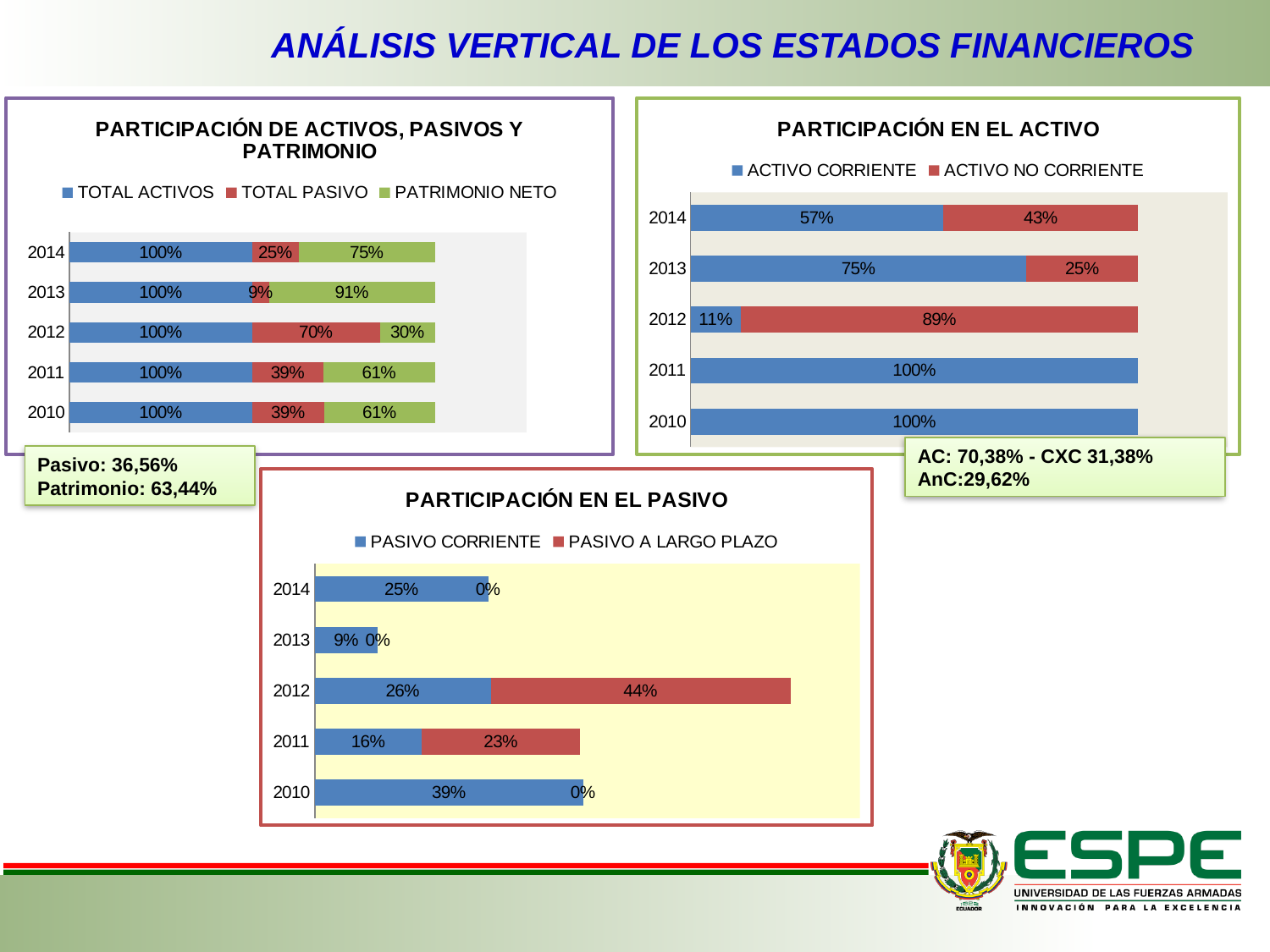
In the chart 'PARTICIPACIÓN EN EL PASIVO', how many series does the legend list? 2 In the chart 'PARTICIPACIÓN EN EL ACTIVO', what is the value of ACTIVO NO CORRIENTE for 2012? 89% In the chart 'PARTICIPACIÓN DE ACTIVOS, PASIVOS Y PATRIMONIO', is TOTAL PASIVO or PATRIMONIO NETO larger in 2014? PATRIMONIO NETO In the chart 'PARTICIPACIÓN EN EL PASIVO', what is the value of PASIVO A LARGO PLAZO for 2012? 44% What kind of chart is 'PARTICIPACIÓN EN EL ACTIVO'? Stacked bar chart In the chart 'PARTICIPACIÓN EN EL PASIVO', what is the difference between PASIVO A LARGO PLAZO and PASIVO CORRIENTE in 2011? 7% In the chart 'PARTICIPACIÓN EN EL ACTIVO', what is the value of ACTIVO CORRIENTE for 2014? 57% In the chart 'PARTICIPACIÓN DE ACTIVOS, PASIVOS Y PATRIMONIO', what is the PATRIMONIO NETO value for 2013? 91% In the chart 'PARTICIPACIÓN EN EL PASIVO', which year has the highest PASIVO CORRIENTE value? 2010 In the chart 'PARTICIPACIÓN EN EL ACTIVO', which year has the highest ACTIVO NO CORRIENTE value? 2012 In the chart 'PARTICIPACIÓN DE ACTIVOS, PASIVOS Y PATRIMONIO', how many years are shown? 5 In the chart 'PARTICIPACIÓN DE ACTIVOS, PASIVOS Y PATRIMONIO', which year has the highest TOTAL PASIVO value? 2012